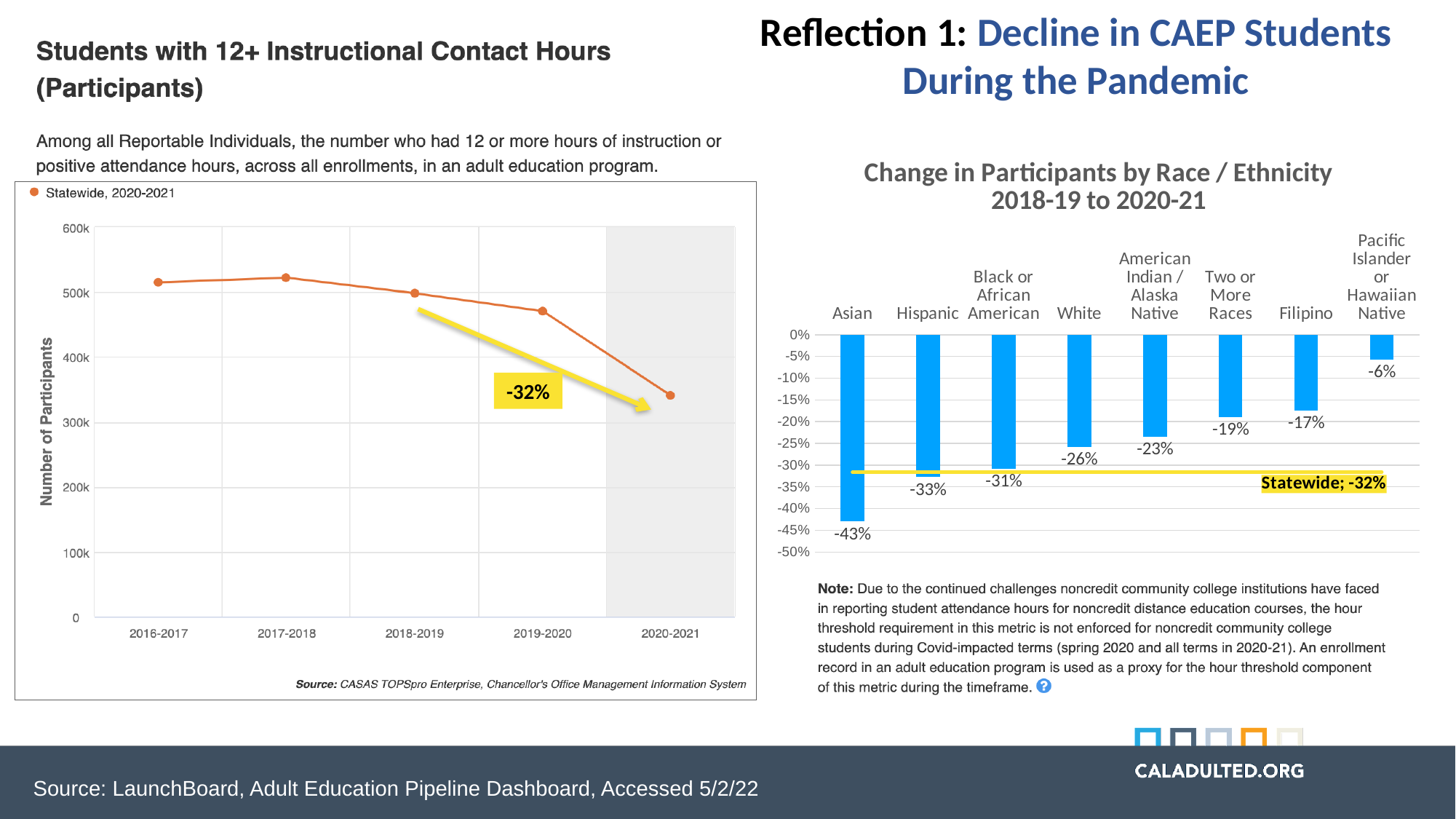
In the 'Change in Participants by Race / Ethnicity' chart, what is the value for Filipino? -17% In the 'Change in Participants by Race / Ethnicity' chart, what is the value for White? -26% In the 'Students with 12+ Instructional Contact Hours (Participants)' chart, do the values rise or fall from 2017-2018 to 2020-2021? fall How many race / ethnicity categories are shown in the 'Change in Participants by Race / Ethnicity' chart? 8 In the 'Change in Participants by Race / Ethnicity' chart, which category shows the largest decline? Asian In the 'Change in Participants by Race / Ethnicity' chart, how many percentage points larger is the decline for Hispanic than for Two or More Races? 14 percentage points What is the statewide change shown on the 'Change in Participants by Race / Ethnicity' chart? -32% In the 'Change in Participants by Race / Ethnicity' chart, which has the larger decline, Black or African American or American Indian / Alaska Native? Black or African American What kind of chart is the 'Students with 12+ Instructional Contact Hours (Participants)' chart on the left? Line chart In the 'Change in Participants by Race / Ethnicity' chart, what is the value for Asian? -43% In the 'Students with 12+ Instructional Contact Hours (Participants)' chart, is the value for 2020-2021 greater or less than 400k? less In the 'Change in Participants by Race / Ethnicity' chart, which category shows the smallest decline? Pacific Islander or Hawaiian Native